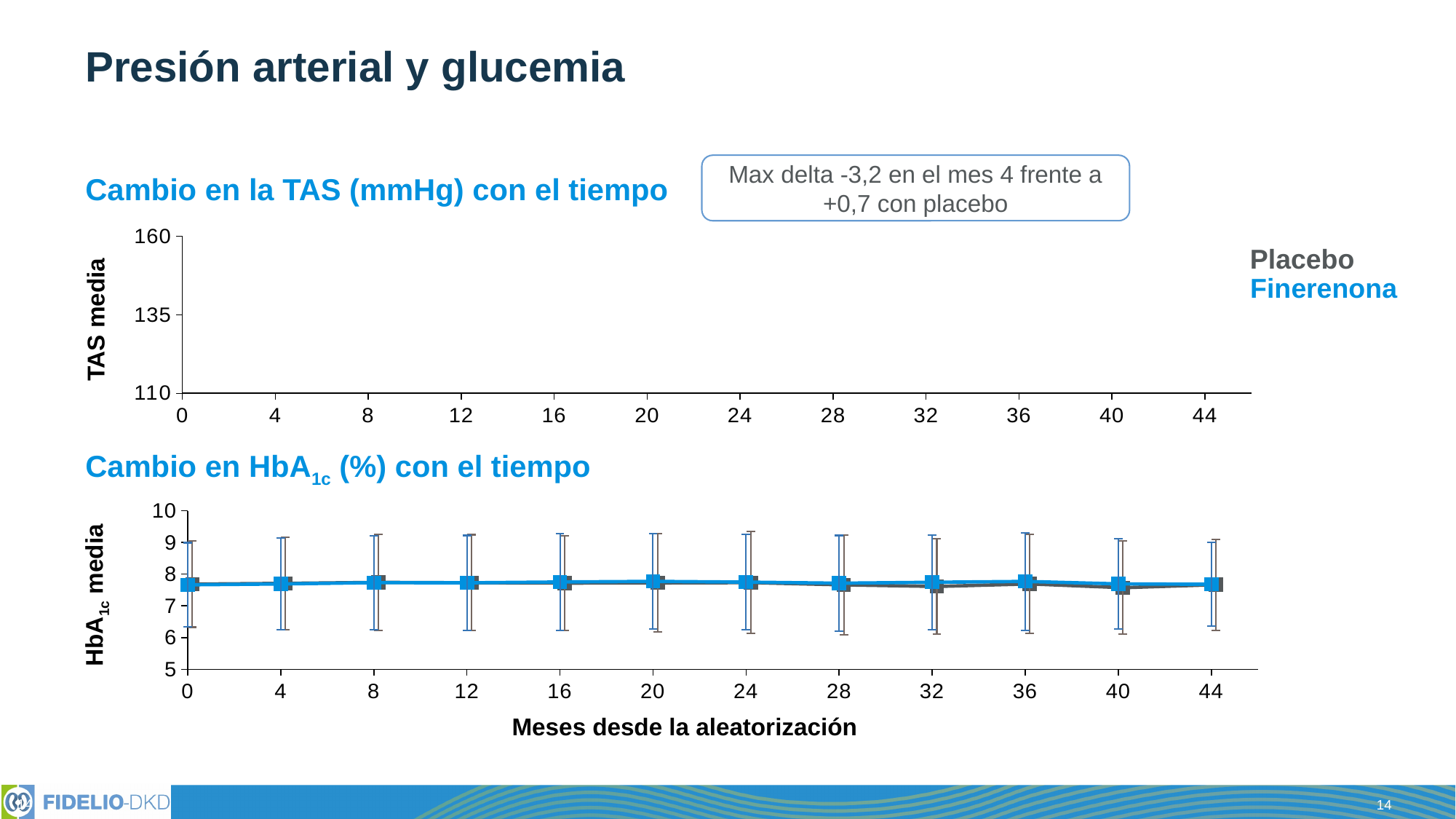
In the 'Cambio en HbA1c (%) con el tiempo' chart, what is the label of the x axis? Meses desde la aleatorización In the 'Cambio en HbA1c (%) con el tiempo' chart, is the Finerenona value at month 0 greater or less than 7? greater Which series is shown in blue on the slide's charts? Finerenona What kind of chart is the 'Cambio en HbA1c (%) con el tiempo' chart? line chart In the 'Cambio en HbA1c (%) con el tiempo' chart, is the Placebo value at month 12 greater or less than 6? greater In the 'Cambio en HbA1c (%) con el tiempo' chart, is the Finerenona value at month 20 greater or less than 9? less In the 'Cambio en HbA1c (%) con el tiempo' chart, do the Finerenona values rise, fall, or stay roughly flat from month 0 to month 44? stay roughly flat In the 'Cambio en HbA1c (%) con el tiempo' chart, how many time points are plotted along the x axis? 12 In the 'Cambio en HbA1c (%) con el tiempo' chart, how many series are plotted? 2